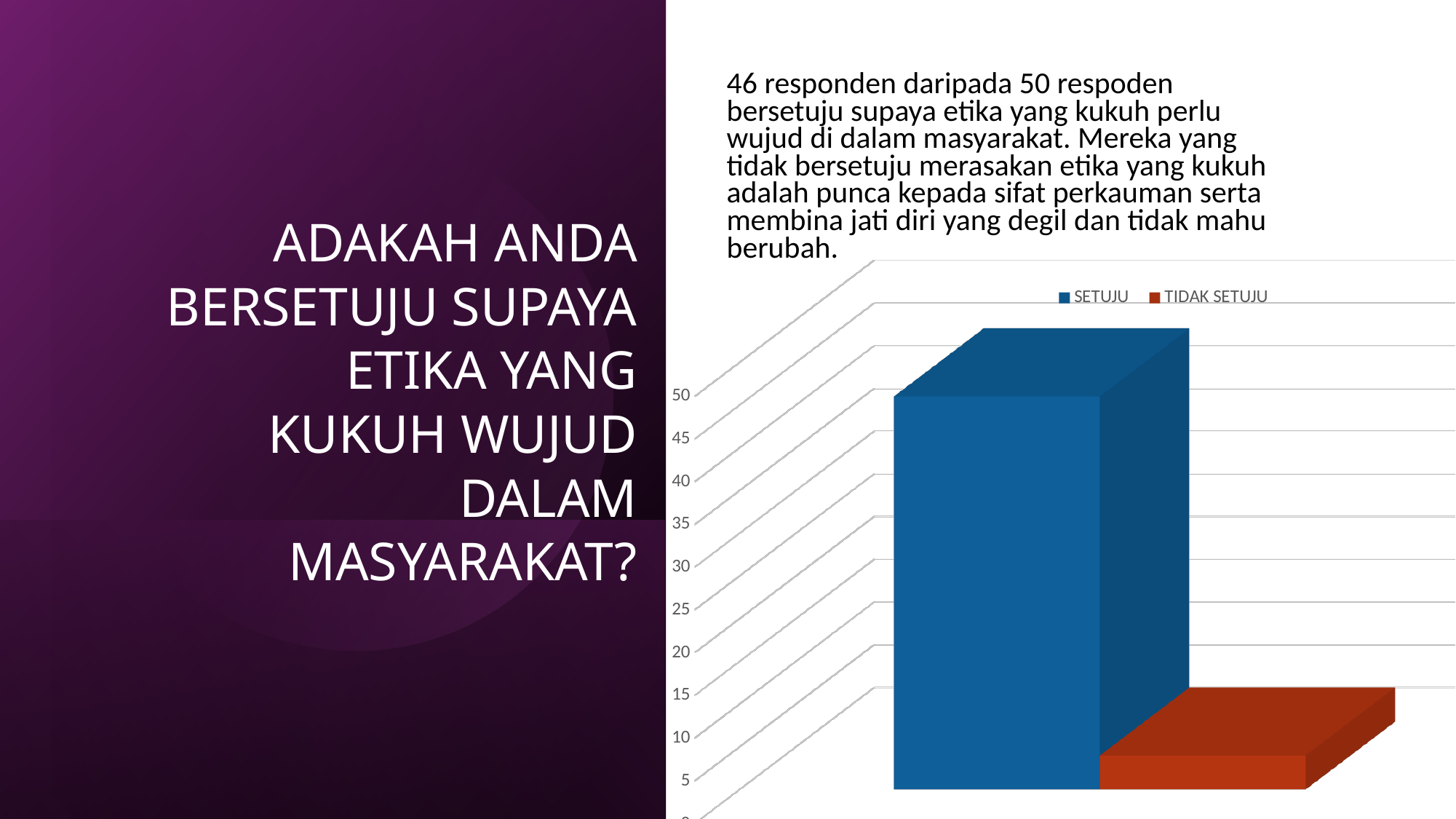
Which series has the lowest value in the chart? TIDAK SETUJU What kind of chart is shown on the slide? bar chart Which is larger, the value for SETUJU or the value for TIDAK SETUJU? SETUJU Is the value for TIDAK SETUJU greater or less than 10? less Which series has the highest value in the chart? SETUJU How many bars are plotted in the chart? 2 What are the two entries listed in the chart legend? SETUJU and TIDAK SETUJU How many series does the chart legend list? 2 Is the value for SETUJU greater or less than 30? greater Is the value for SETUJU greater or less than 40? greater What colour is the SETUJU series in the chart? blue